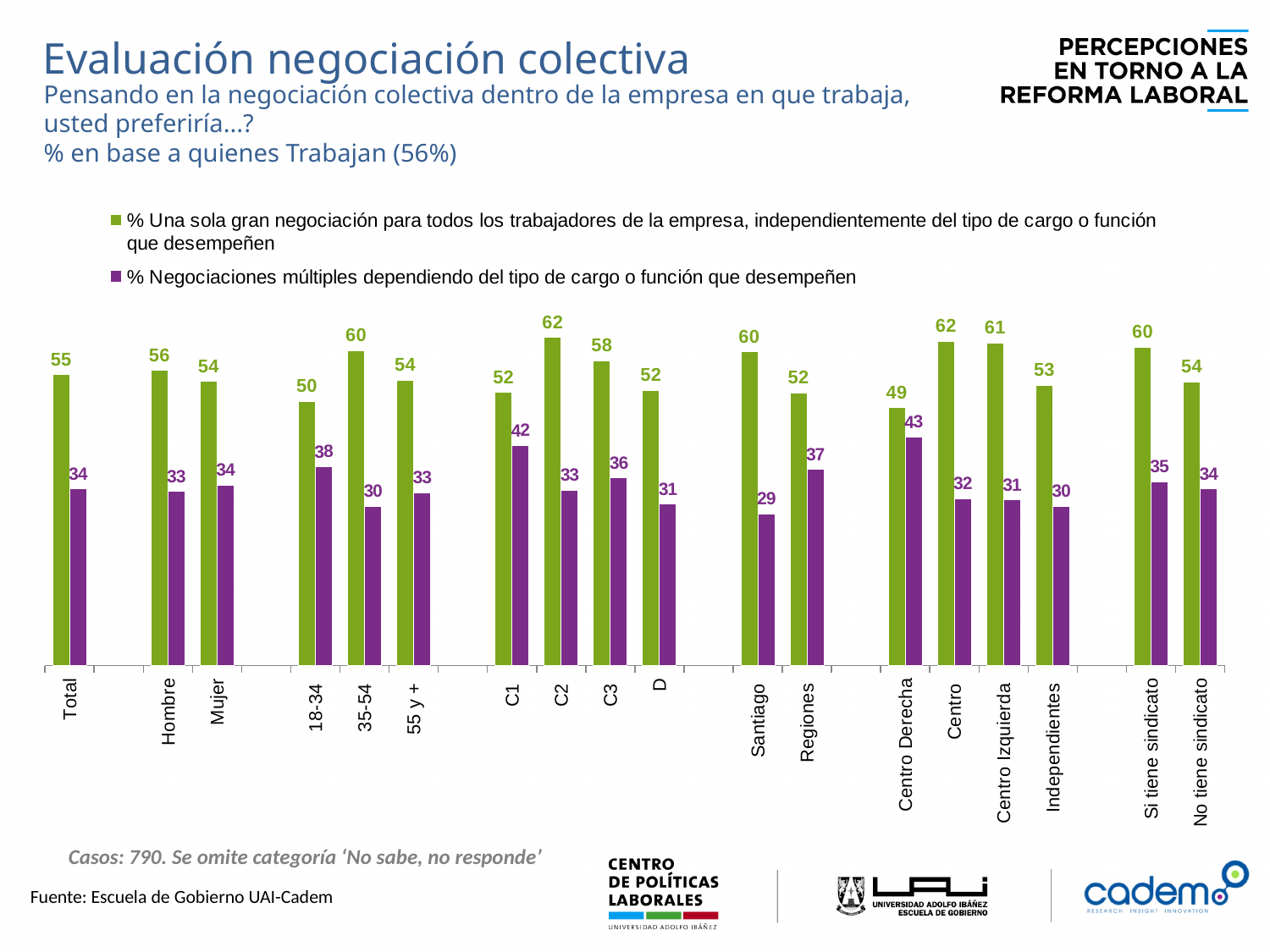
What kind of chart is shown on the slide? Bar chart What is the value of the green series for Centro Izquierda? 61 How many categories are shown on the x axis? 18 What is the value of the purple series (negociaciones múltiples) for C1? 42 Which category has the lowest value in the green series (una sola gran negociación)? Centro Derecha Which category has the highest value in the purple series (negociaciones múltiples)? Centro Derecha What is the value of the green series (una sola gran negociación) for Total? 55 What is the difference between the purple values for 18-34 and 35-54? 8 How many series does the legend list? 2 Which category has the lowest value in the purple series (negociaciones múltiples)? Santiago What is the difference between the green and purple values for Santiago? 31 Which is larger: the green value for Hombre or the green value for Mujer? Hombre